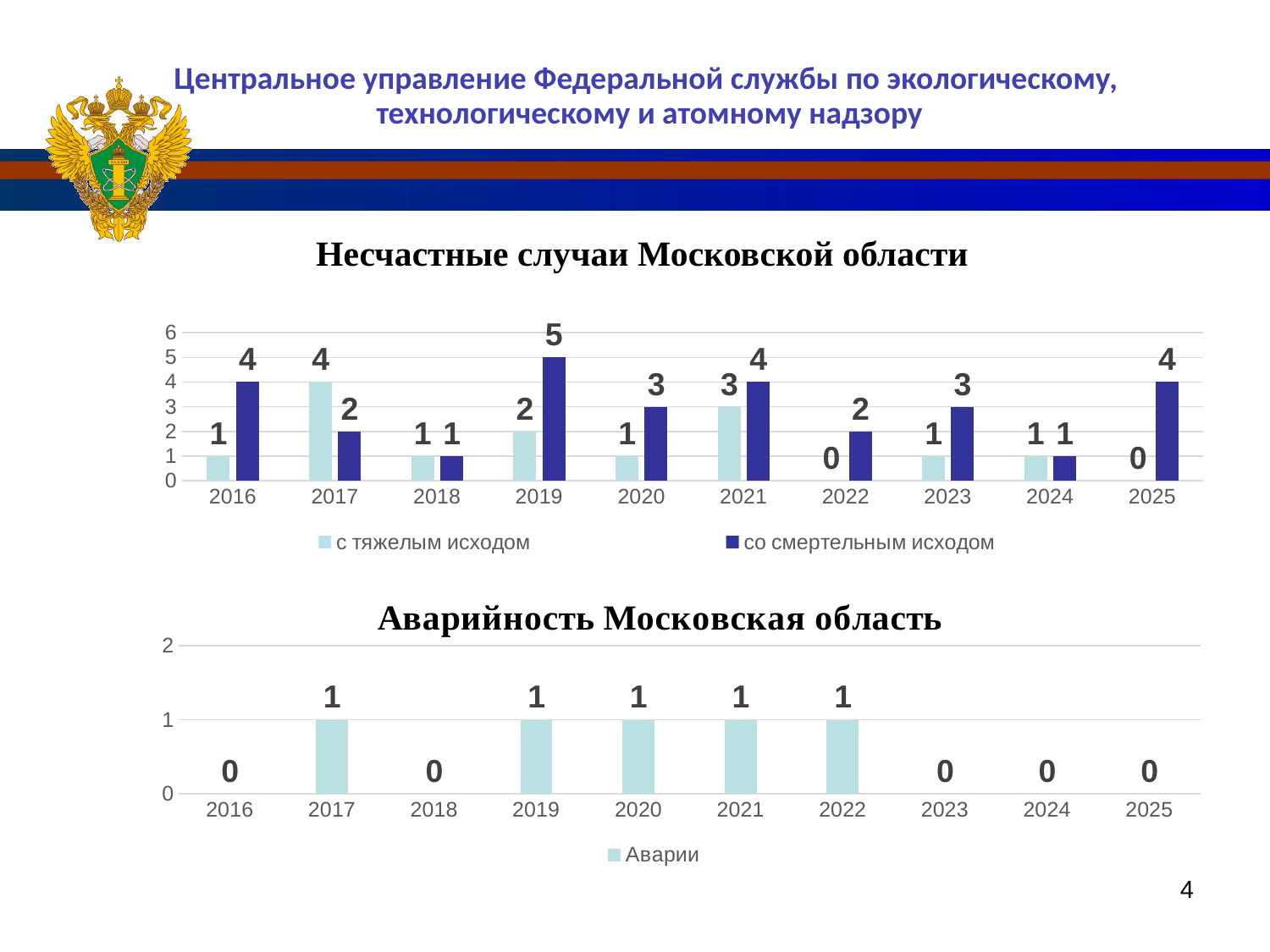
How many series does the legend of the chart 'Несчастные случаи Московской области' list? 2 What is the name of the series in the legend of the chart 'Аварийность Московская область'? Аварии What kind of chart is 'Аварийность Московская область'? bar chart In the chart 'Несчастные случаи Московской области', what is the value for 'с тяжелым исходом' in 2017? 4 In the chart 'Несчастные случаи Московской области', which is larger in 2017: 'с тяжелым исходом' or 'со смертельным исходом'? с тяжелым исходом In the chart 'Аварийность Московская область', what is the value for 2020? 1 In the chart 'Аварийность Московская область', how many years have a value of 1? 5 How many years are shown on the x axis of the chart 'Несчастные случаи Московской области'? 10 In the chart 'Несчастные случаи Московской области', which year has the highest value for 'со смертельным исходом'? 2019 In the chart 'Несчастные случаи Московской области', what is the difference between 'со смертельным исходом' and 'с тяжелым исходом' in 2025? 4 In the chart 'Несчастные случаи Московской области', what is the value for 'со смертельным исходом' in 2019? 5 In the chart 'Аварийность Московская область', what is the value for 2023? 0